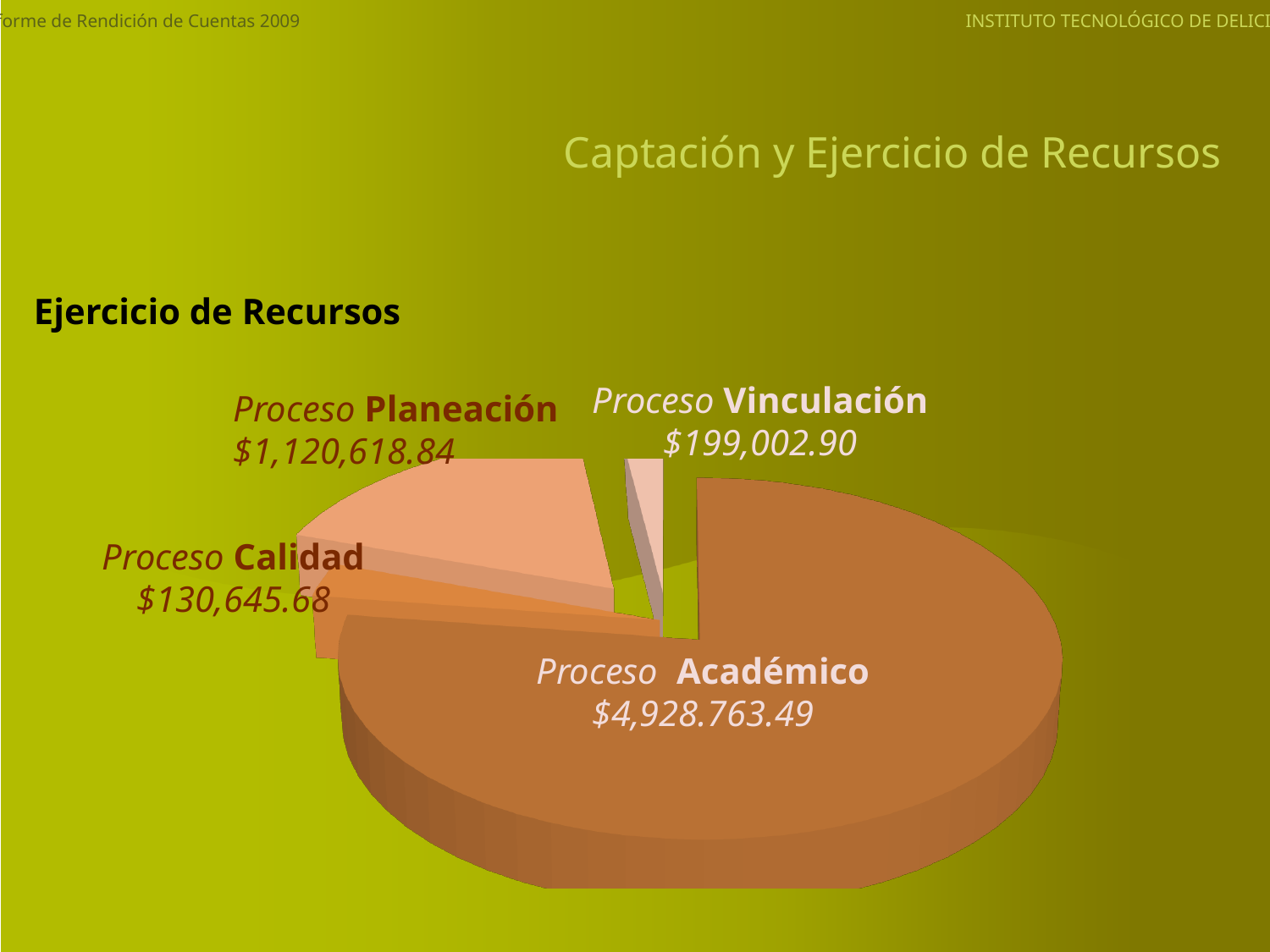
What is the value shown for Proceso Académico? $4,928.763.49 What is the difference between the values for Proceso Planeación and Proceso Vinculación? $921,615.94 Which process has the smallest slice of the pie? Proceso Calidad What is the value shown for Proceso Planeación? $1,120,618.84 What is the value shown for Proceso Calidad? $130,645.68 What kind of chart is shown on the slide? pie chart How many slices does the pie chart have? 4 Which process has the largest slice of the pie? Proceso Académico What is the difference between the values for Proceso Vinculación and Proceso Calidad? $68,357.22 Which is larger, the value for Proceso Planeación or Proceso Vinculación? Proceso Planeación What heading is shown above the pie chart? Ejercicio de Recursos What is the value shown for Proceso Vinculación? $199,002.90